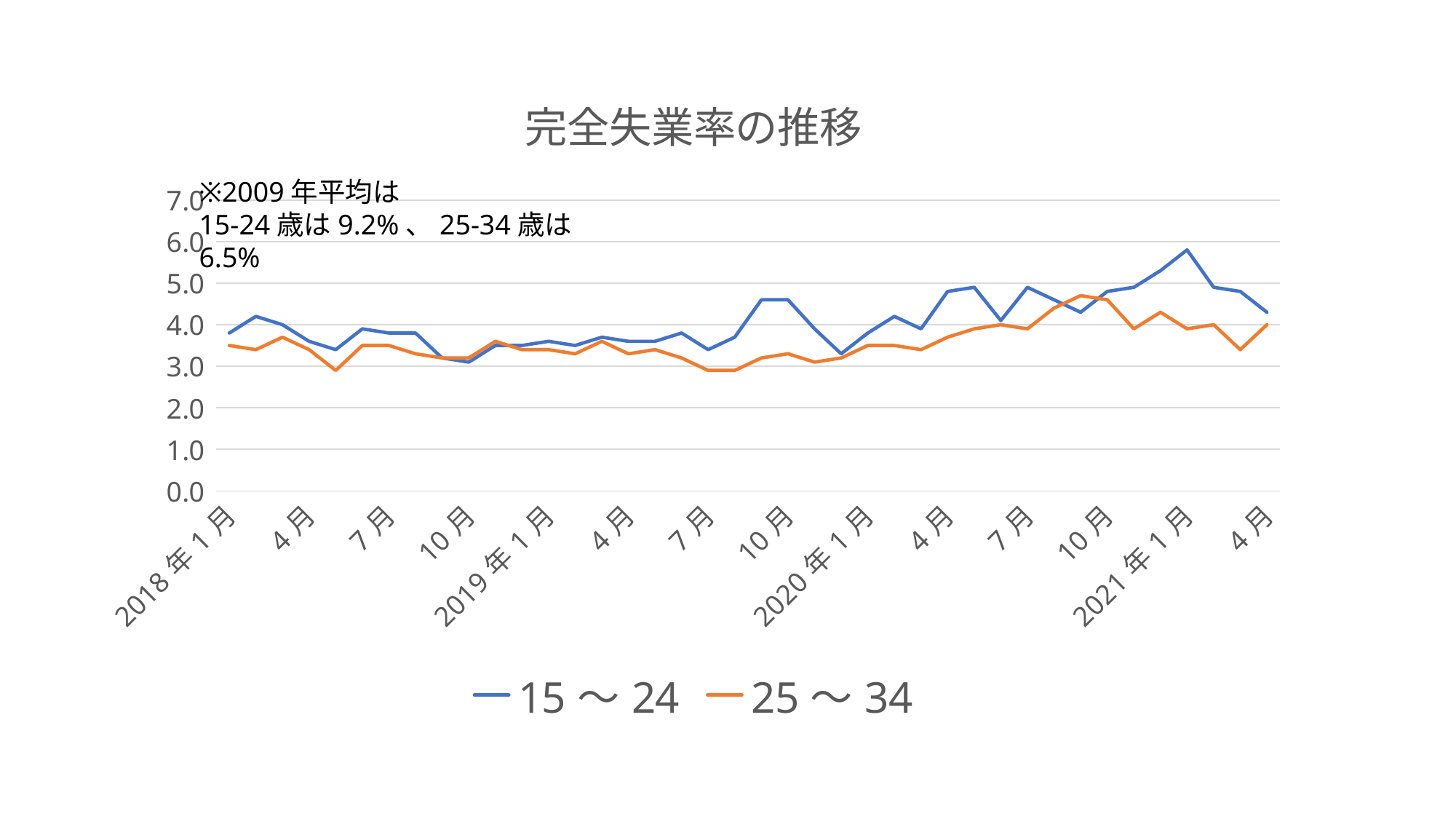
Does the 15～24 series generally rise or fall from 2018年1月 to 2021年1月? rise Is the value for 25～34 in 2020年10月 greater or less than 4.0? greater How many series does the legend list? 2 In 2019年10月, which series has the higher value, 15～24 or 25～34? 15～24 Is the value for 15～24 in 2019年10月 greater or less than 4.0? greater In 2020年10月, which series has the higher value, 15～24 or 25～34? 15～24 Is the value for 15～24 in 2020年1月 greater or less than 4.0? less What are the two series named in the legend? 15～24 and 25～34 What is the title of the chart? 完全失業率の推移 What kind of chart is shown on the slide? line chart Which series reaches the highest value anywhere on the chart? 15～24